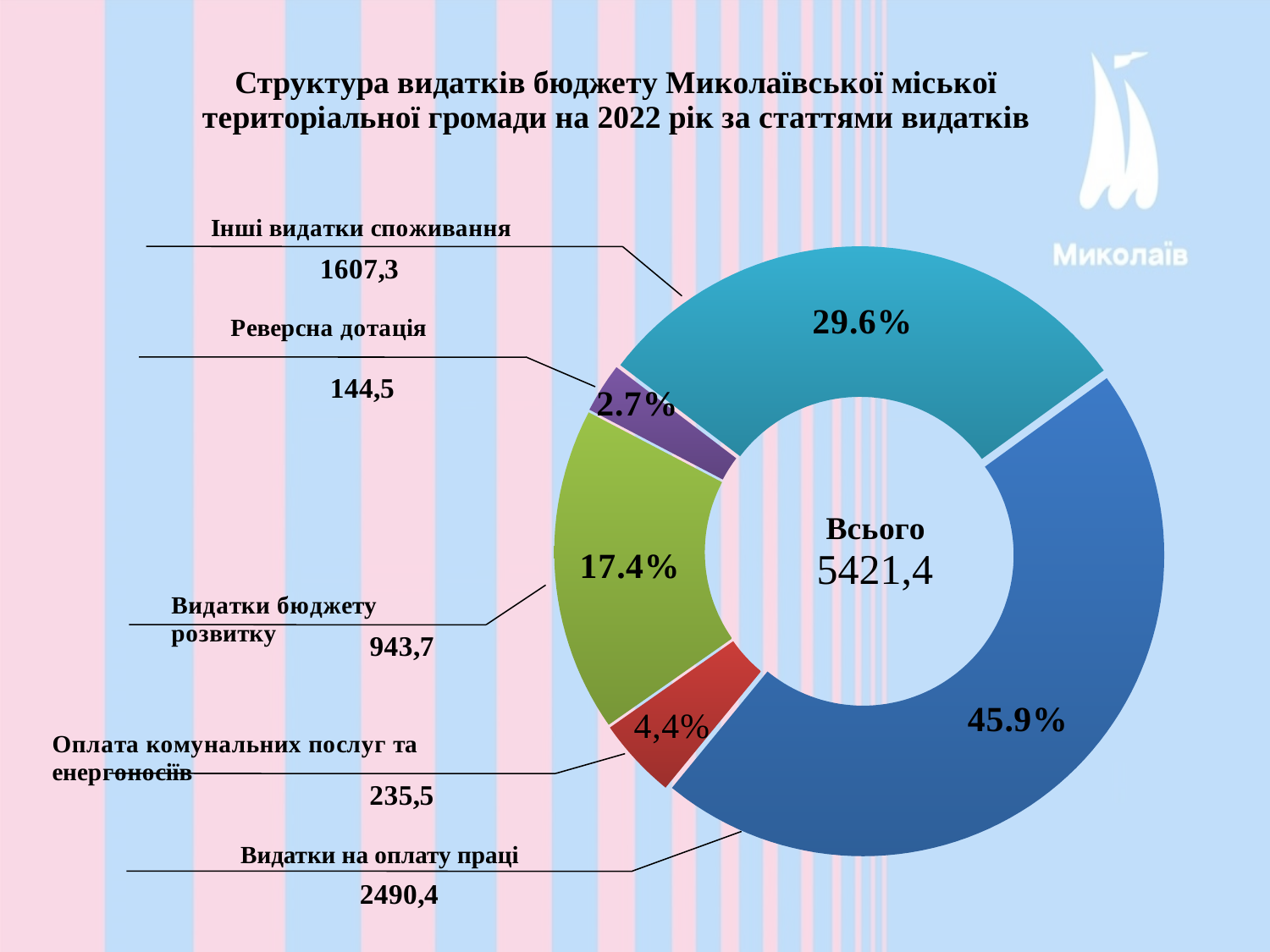
What share of the total does Видатки на оплату праці represent? 45.9% What is the value for Оплата комунальних послуг та енергоносіїв? 235,5 What is the value for Реверсна дотація? 144,5 What total value is shown in the centre of the chart? 5421,4 How many categories does the chart show? 5 What is the value for Видатки на оплату праці? 2490,4 What kind of chart is shown on the slide? Pie chart (doughnut) Which category has the smallest share? Реверсна дотація What is the difference between Видатки на оплату праці and Інші видатки споживання? 883,1 What is the value for Інші видатки споживання? 1607,3 Which category has the largest share? Видатки на оплату праці What share of the total does Видатки бюджету розвитку represent? 17.4%